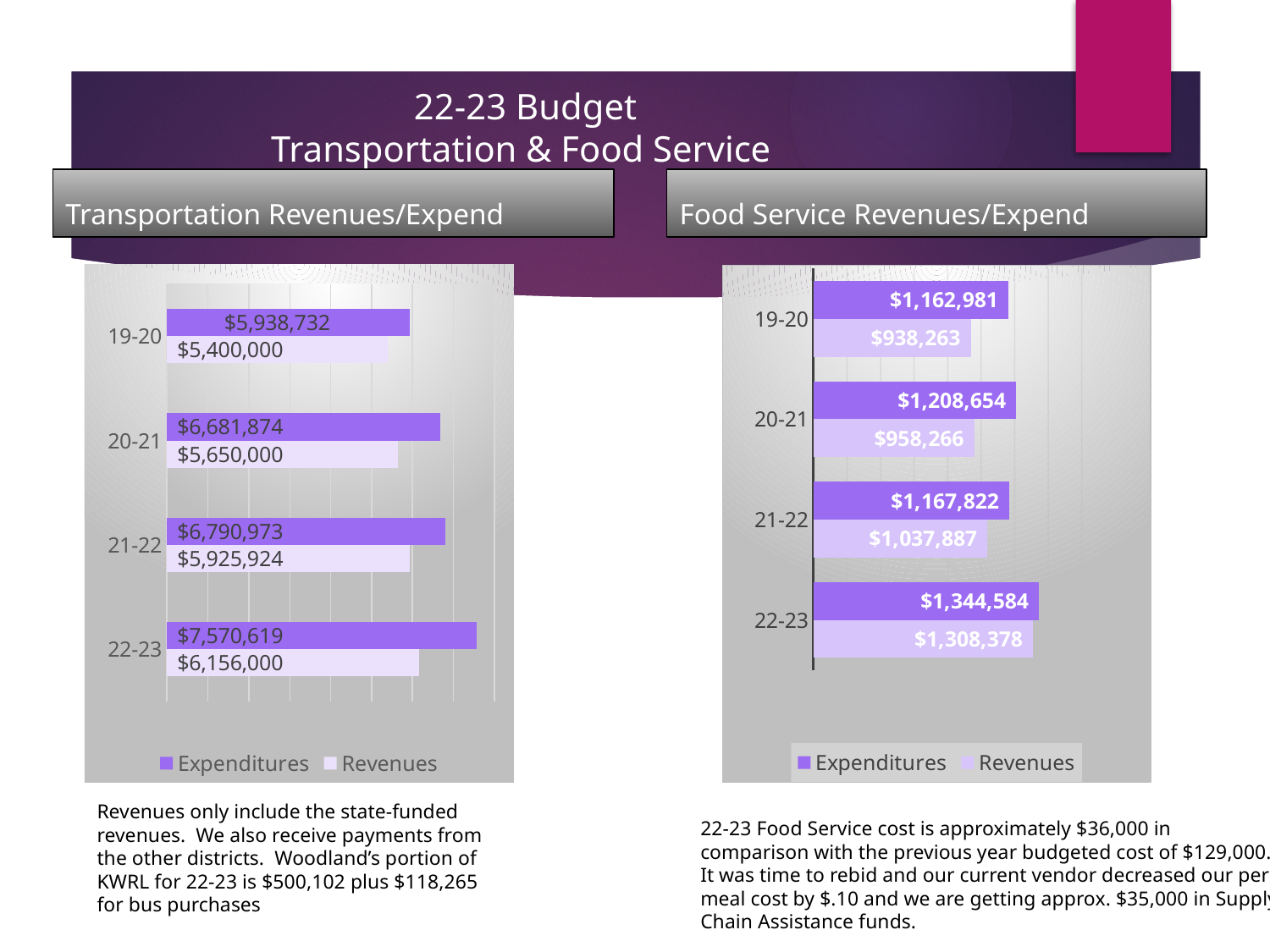
What type of chart is the Transportation Revenues/Expend chart? Bar chart In the Food Service Revenues/Expend chart, which is larger for 21-22: Expenditures or Revenues? Expenditures In the Transportation Revenues/Expend chart, what are the Expenditures for 22-23? $7,570,619 In the Transportation Revenues/Expend chart, what are the Revenues for 19-20? $5,400,000 How many years are shown in the Transportation Revenues/Expend chart? 4 In the Food Service Revenues/Expend chart, what are the Revenues for 21-22? $1,037,887 In the Food Service Revenues/Expend chart, what is the difference between Expenditures and Revenues for 22-23? $36,206 How many series does the legend of the Food Service Revenues/Expend chart list? 2 In the Transportation Revenues/Expend chart, what is the difference between Expenditures and Revenues for 22-23? $1,414,619 In the Food Service Revenues/Expend chart, what are the Expenditures for 20-21? $1,208,654 In the Transportation Revenues/Expend chart, which year has the highest Expenditures? 22-23 In the Food Service Revenues/Expend chart, which year has the lowest Revenues? 19-20